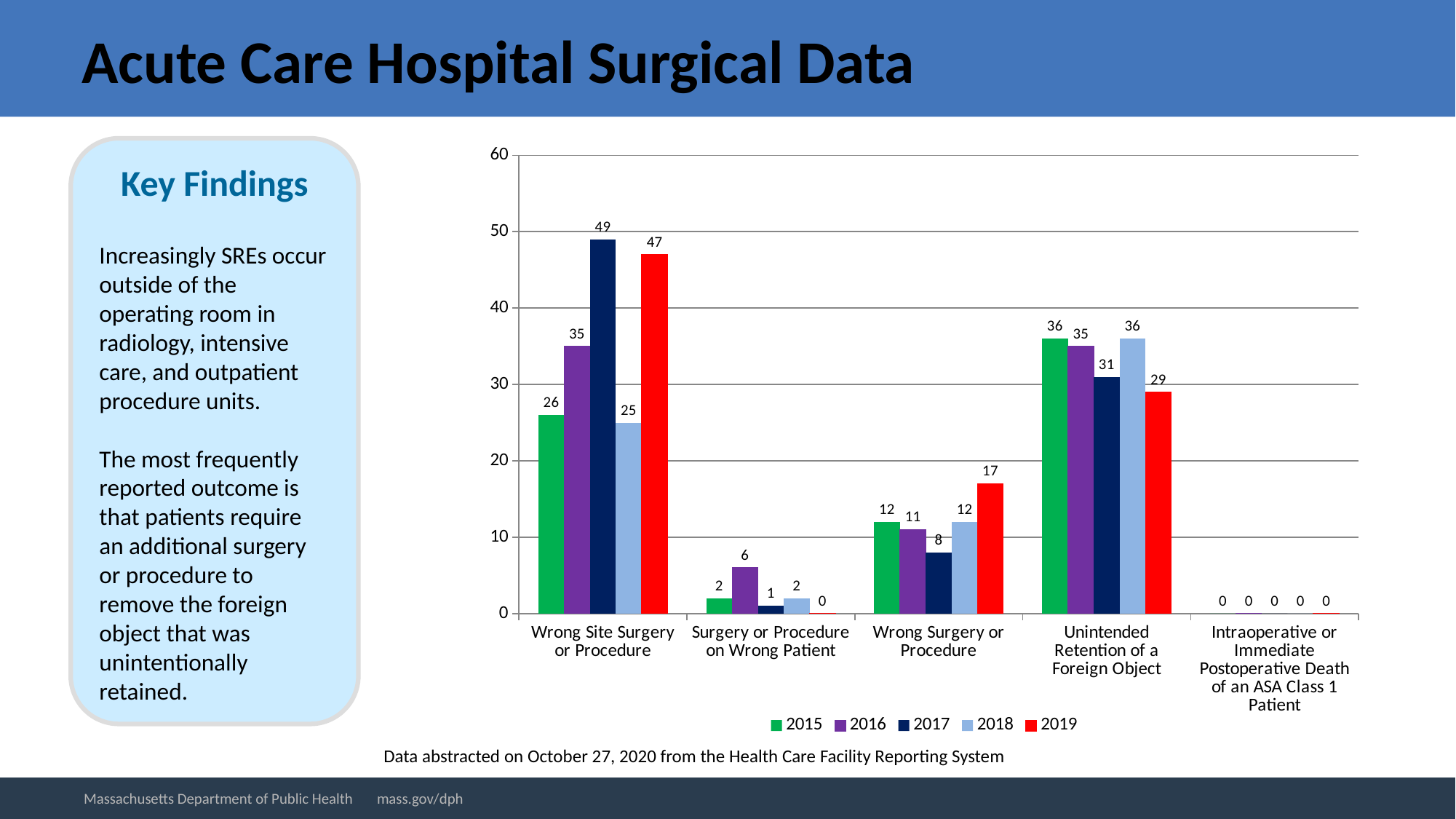
What is the difference between the 2017 and 2015 values for Wrong Site Surgery or Procedure? 23 How many categories are shown on the x axis? 5 What is the value for Intraoperative or Immediate Postoperative Death of an ASA Class 1 Patient in 2018? 0 Which colour represents 2019 in the legend? red What is the value for Surgery or Procedure on Wrong Patient in 2016? 6 What is the value for Unintended Retention of a Foreign Object in 2019? 29 Which is larger for Unintended Retention of a Foreign Object: the 2015 value or the 2017 value? 2015 How many series does the legend list? 5 Which year has the lowest value for Wrong Site Surgery or Procedure? 2018 What kind of chart is shown on the slide? bar chart Which year has the highest value for Wrong Surgery or Procedure? 2019 What is the value for Wrong Site Surgery or Procedure in 2017? 49